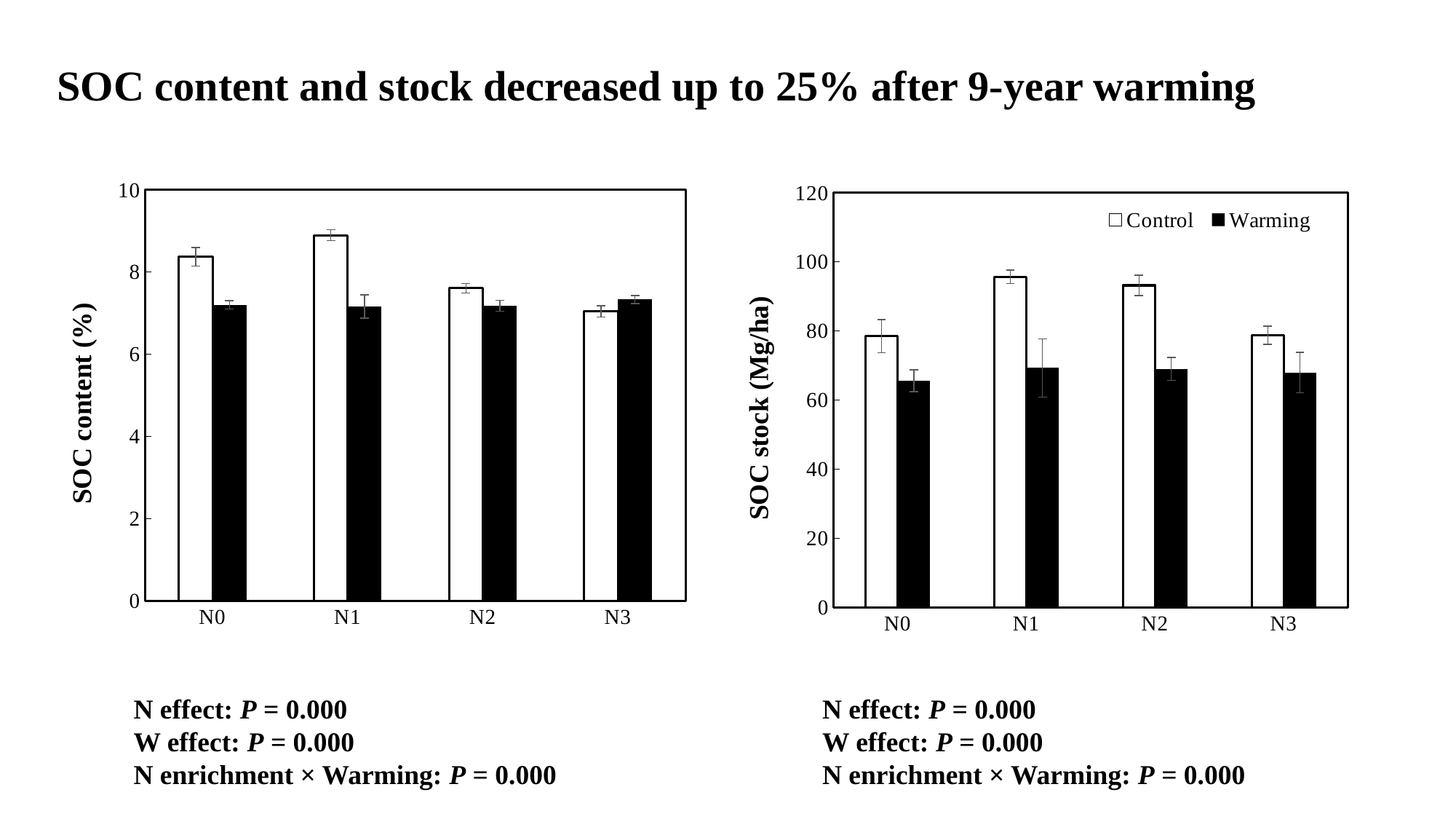
How many series does the legend of the right chart (SOC stock) list? 2 In the left chart (SOC content), is the Control value for N1 greater or less than 8? greater In the right chart (SOC stock), is the Warming value for N0 greater or less than 80? less In the left chart (SOC content), which category has the highest Control bar? N1 In the right chart (SOC stock), which is larger for N1, the Control bar or the Warming bar? Control In the left chart (SOC content), which category has the lowest Control bar? N3 In the left chart (SOC content), is the Control value for N3 greater or less than 8? less What is the y-axis label of the right chart? SOC stock (Mg/ha) In the left chart (SOC content), do the Control bars rise or fall from N1 to N3? fall What kind of chart is the left chart (SOC content)? bar chart How many categories are shown on the x axis of the right chart (SOC stock)? 4